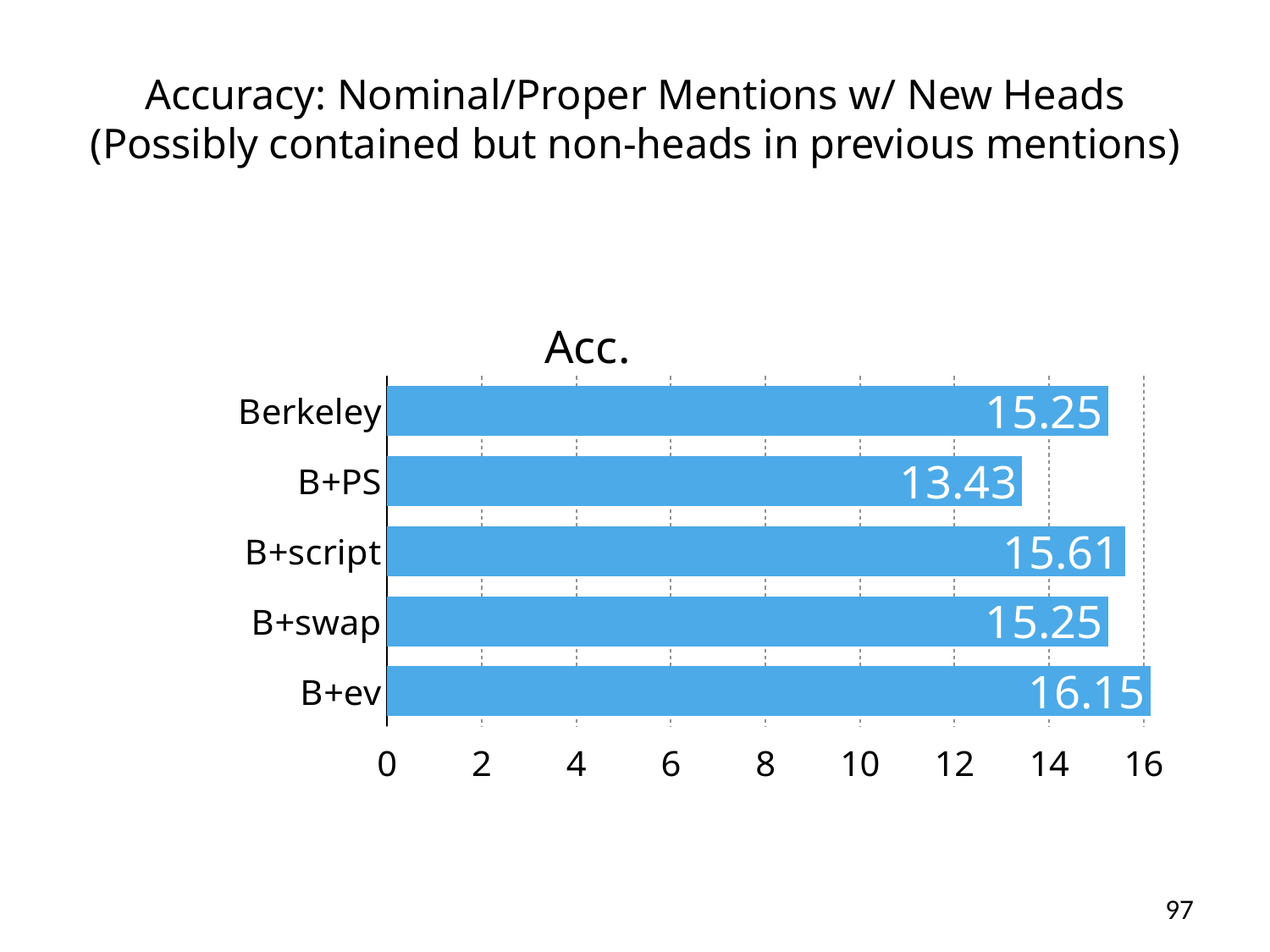
Which category has the highest Acc. value? B+ev What is the difference between the Acc. values for B+ev and B+PS? 2.72 Which has a larger Acc. value, B+script or B+PS? B+script What is the Acc. value for B+ev? 16.15 Which category has the lowest Acc. value? B+PS What is the Acc. value for B+script? 15.61 What is the difference between the Acc. values for B+script and B+swap? 0.36 How many categories are shown in the chart? 5 What is the Acc. value for Berkeley? 15.25 What is the Acc. value for B+PS? 13.43 Is the value for B+PS greater or less than 14? less What kind of chart is shown on the slide? bar chart